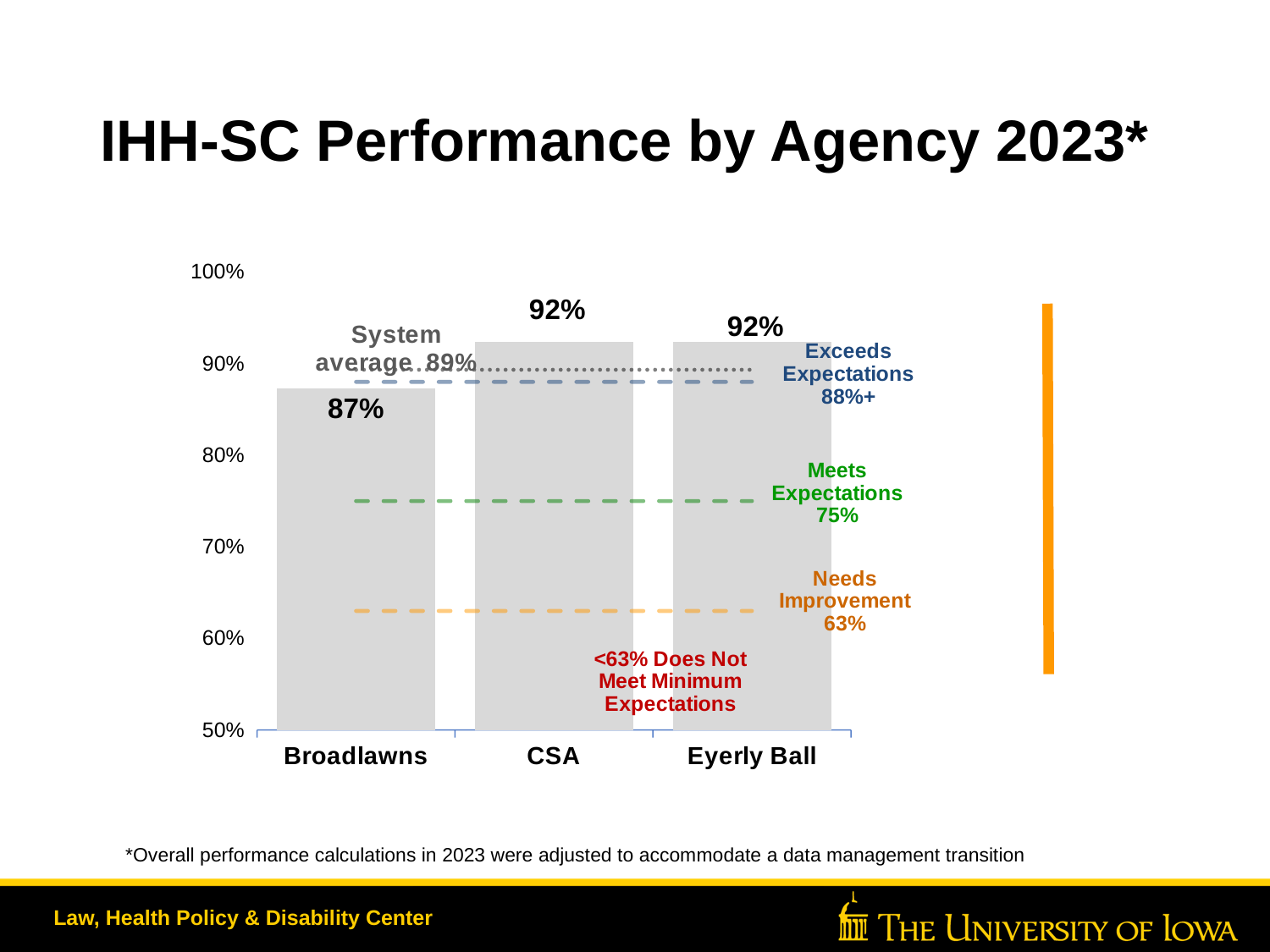
What is the title of the chart? IHH-SC Performance by Agency 2023* What threshold is labelled as 'Meets Expectations' on the chart? 75% Which agency has the lowest value? Broadlawns What is the value for CSA? 92% What is the system average shown on the chart? 89% Is the value for Broadlawns greater or less than 80%? greater What is the value for Broadlawns? 87% What is the difference between the values for CSA and Broadlawns? 5% What kind of chart is shown on the slide? bar chart How many agencies are shown on the chart? 3 What is the value for Eyerly Ball? 92% Which is larger, the value for Broadlawns or the value for Eyerly Ball? Eyerly Ball